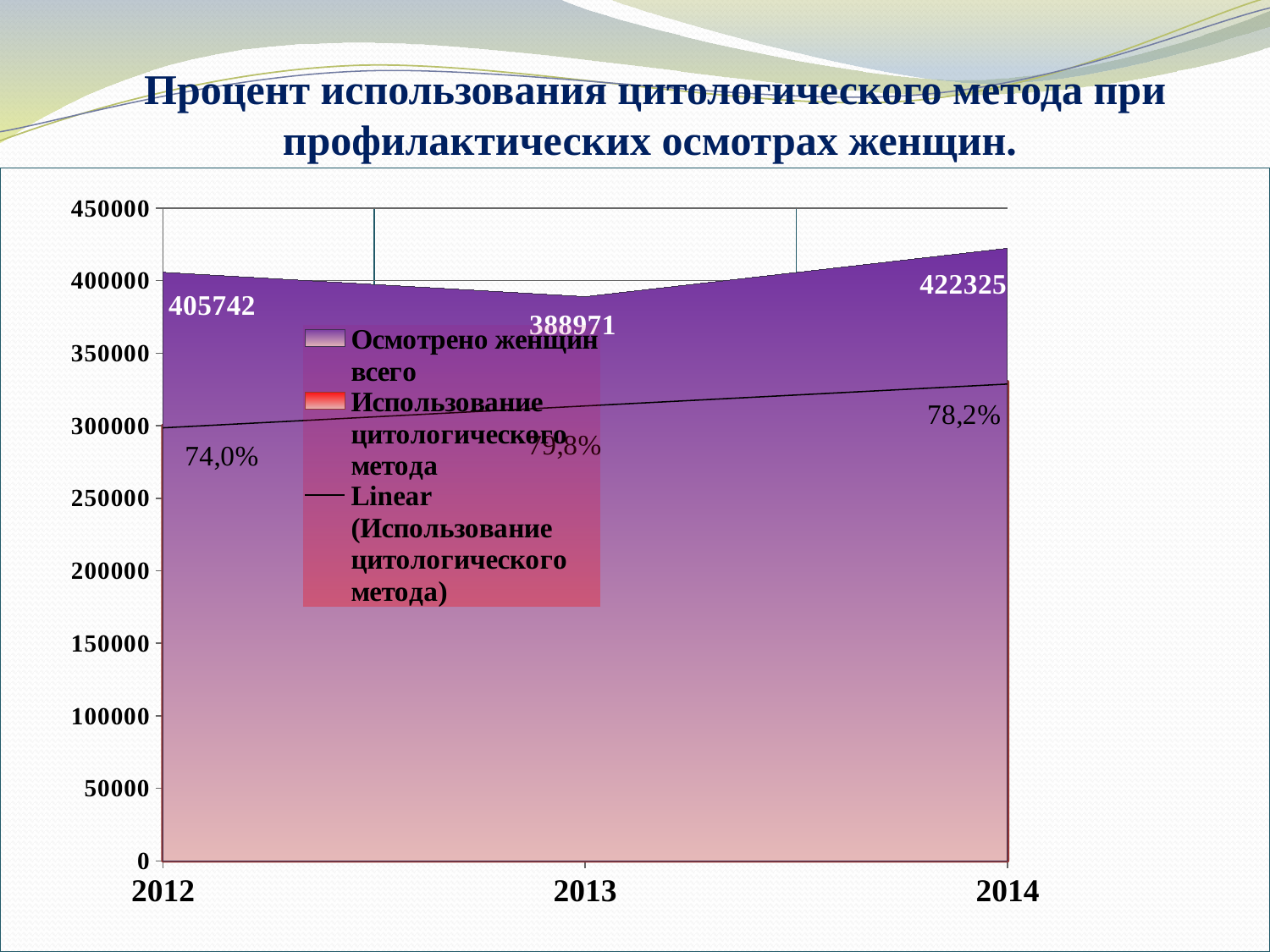
In which year is "Осмотрено женщин всего" the highest? 2014 What is the value of "Осмотрено женщин всего" for 2013? 388971 How many years are shown on the x axis? 3 What is the difference between the "Осмотрено женщин всего" values for 2014 and 2012? 16583 How many entries does the legend list? 3 Which year has the larger "Осмотрено женщин всего" value, 2012 or 2013? 2012 What kind of chart is shown on the slide? Area chart What percentage label is shown for 2014? 78,2% In which year is "Осмотрено женщин всего" the lowest? 2013 What is the value of "Осмотрено женщин всего" for 2014? 422325 What percentage label is shown for 2012? 74,0% What is the value of "Осмотрено женщин всего" for 2012? 405742